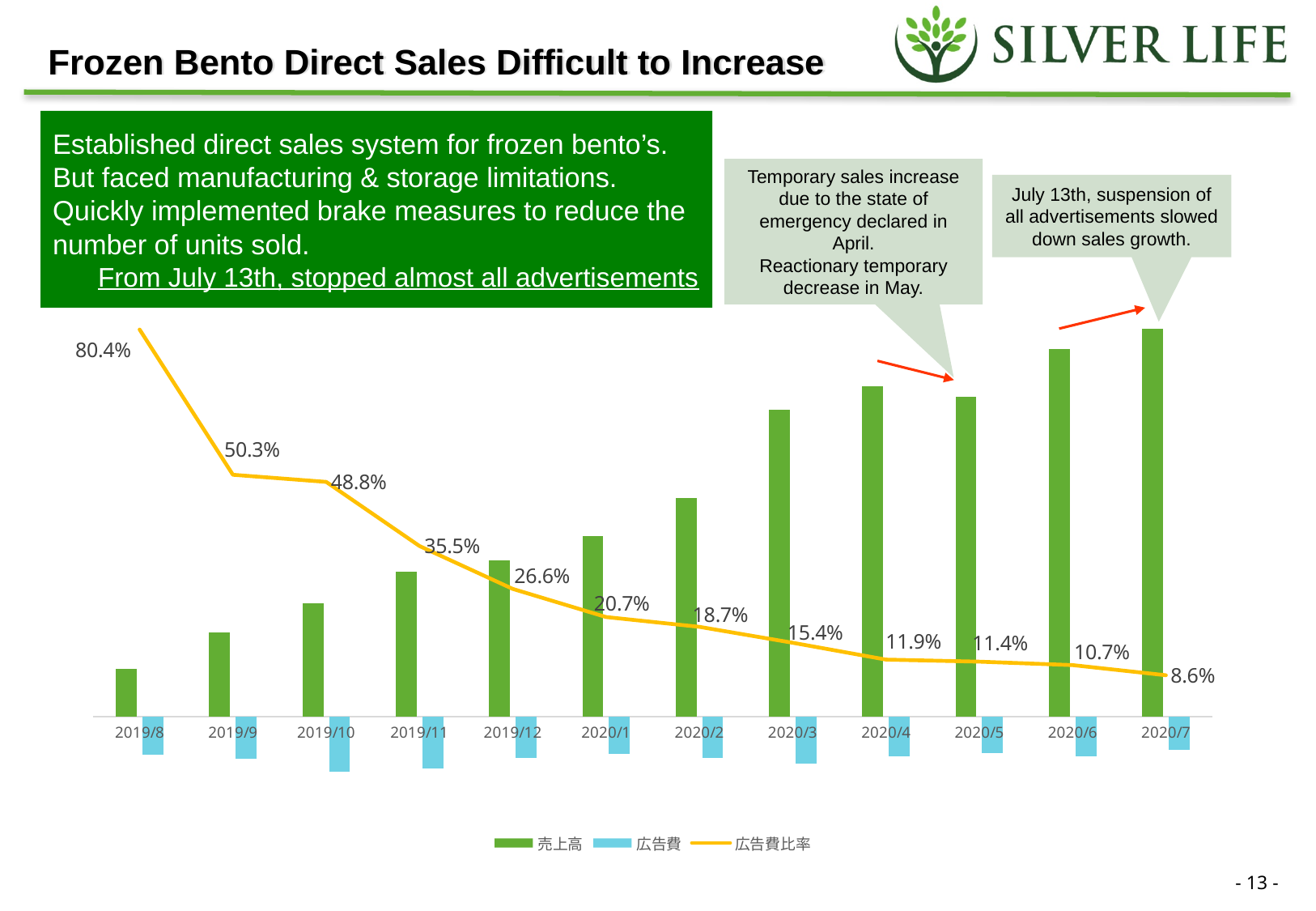
What is the value of the yellow line (広告費比率) for 2020/7? 8.6% Which month has the larger yellow line value, 2019/10 or 2019/11? 2019/10 How many months are shown on the x axis of the chart? 12 What is the value of the yellow line (広告費比率) for 2020/1? 20.7% What kind of chart is shown on the slide? Combination bar and line chart How many series does the chart legend list? 3 Which month has the lowest value on the yellow line (広告費比率)? 2020/7 What is the value of the yellow line (広告費比率) for 2019/8? 80.4% What is the difference between the yellow line values for 2020/6 and 2020/7? 2.1 percentage points What is the difference between the yellow line values for 2019/8 and 2019/9? 30.1 percentage points Which month has the highest value on the yellow line (広告費比率)? 2019/8 Does the yellow line (広告費比率) rise or fall from 2019/8 to 2020/7? Fall